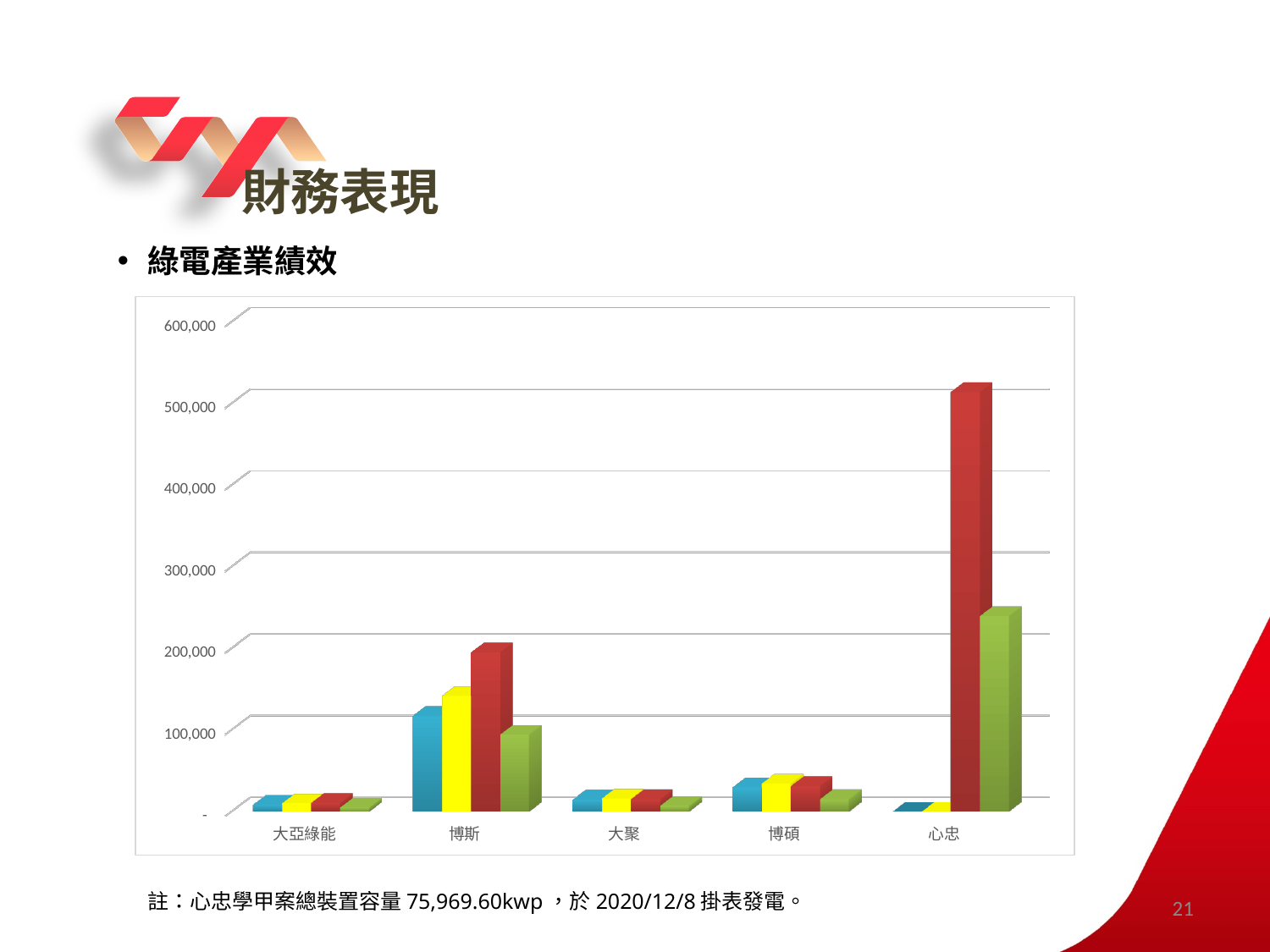
How many categories are shown on the x axis of the chart? 5 Is the value of the green bar for 心忠 greater or less than 300,000? less Is the value of the red bar for 博斯 greater or less than 300,000? less Which category has the tallest bar in the chart? 心忠 Is the value of the green bar for 心忠 greater or less than 200,000? greater What is the highest value shown on the chart's vertical axis? 600,000 What kind of chart is shown on the slide? bar chart Which has the larger red bar, 心忠 or 博斯? 心忠 Which has the larger red bar, 博斯 or 大聚? 博斯